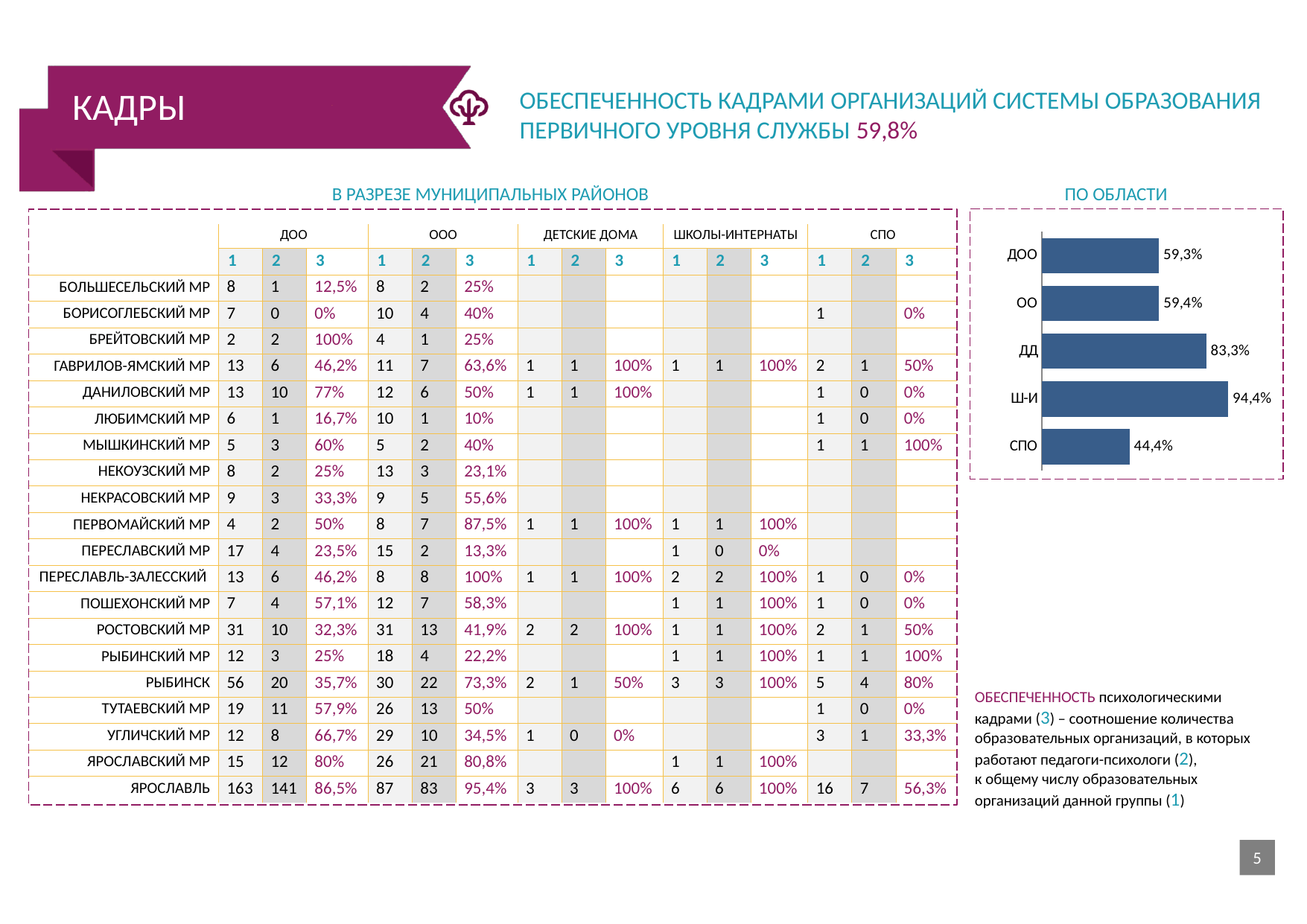
What kind of chart is the chart titled "ПО ОБЛАСТИ"? Bar chart In the chart titled "ПО ОБЛАСТИ", what is the value for СПО? 44,4% In the chart titled "ПО ОБЛАСТИ", what is the value for ДД? 83,3% In the chart titled "ПО ОБЛАСТИ", which category has the highest value? Ш-И In the chart titled "ПО ОБЛАСТИ", which category has the lowest value? СПО In the chart titled "ПО ОБЛАСТИ", what is the difference between the values for Ш-И and СПО? 50,0% How many categories are shown in the chart titled "ПО ОБЛАСТИ"? 5 In the chart titled "ПО ОБЛАСТИ", what is the value for ДОО? 59,3% In the chart titled "ПО ОБЛАСТИ", what is the value for ОО? 59,4% In the chart titled "ПО ОБЛАСТИ", what is the value for Ш-И? 94,4% In the chart titled "ПО ОБЛАСТИ", what is the difference between the values for ДД and ДОО? 24,0% In the chart titled "ПО ОБЛАСТИ", which is larger, the value for ДД or the value for СПО? ДД